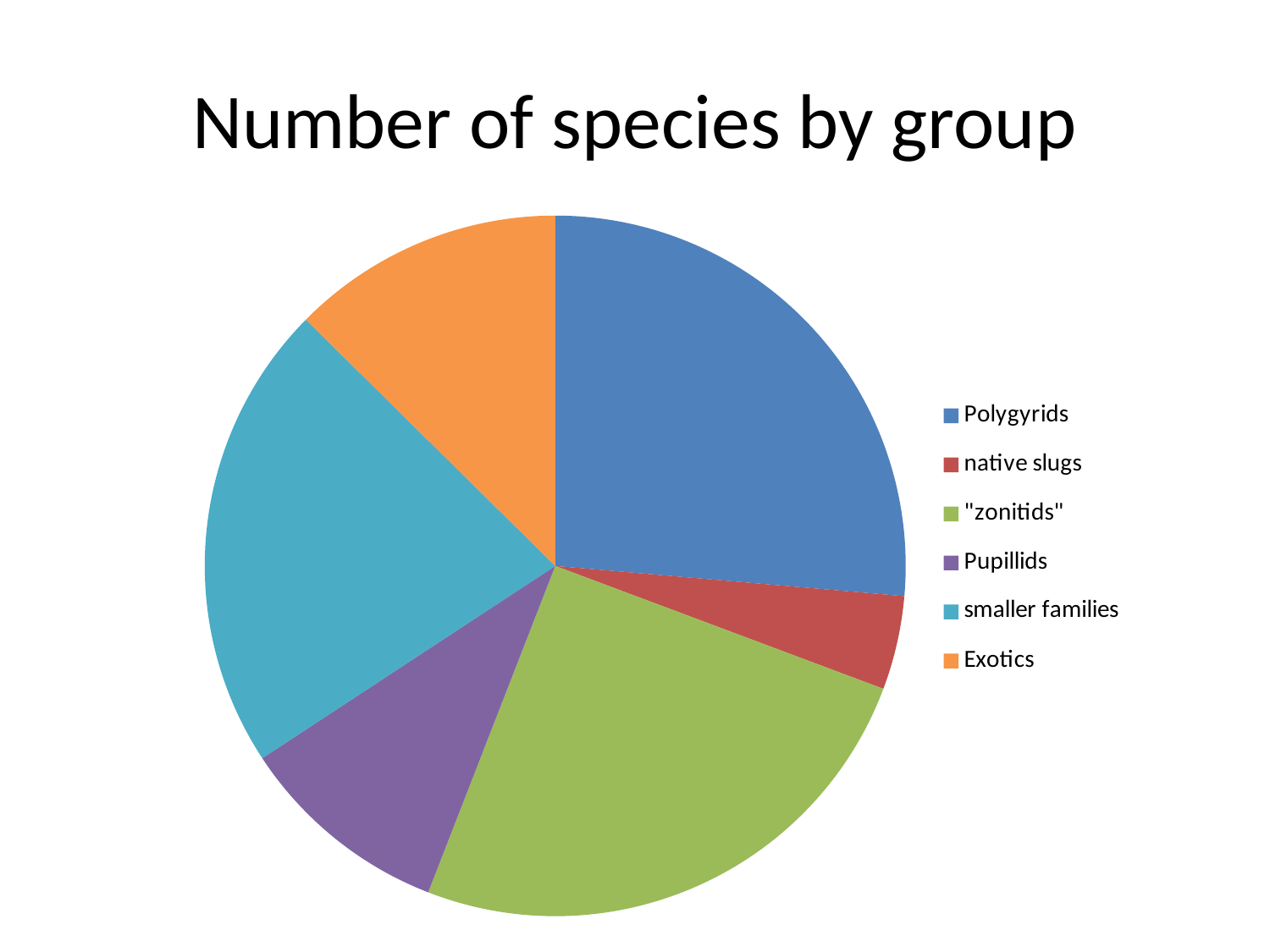
What is the title of the chart? Number of species by group Which group is shown in orange in the legend? Exotics How many entries does the legend list? 6 Which slice is larger, Polygyrids or native slugs? Polygyrids Which slice is larger, Exotics or native slugs? Exotics Which group has the smallest slice of the pie? native slugs What kind of chart is shown on the slide? pie chart Which slice is larger, "zonitids" or Pupillids? "zonitids" How many groups (slices) does the pie chart show? 6